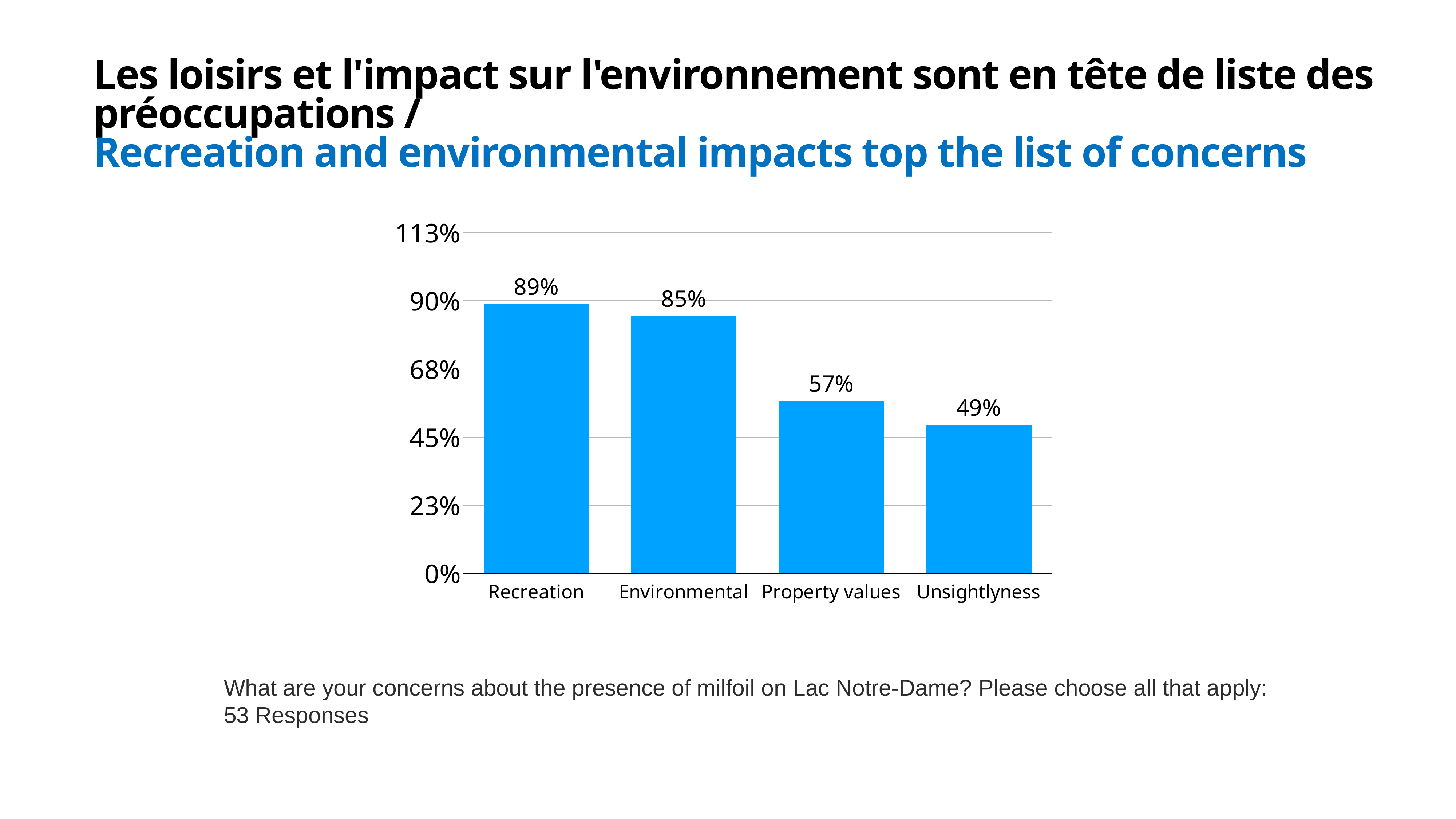
What is the value for Recreation? 89% What is the value for Unsightlyness? 49% Which category has the highest value? Recreation Which category has the lowest value? Unsightlyness How many categories are shown on the x axis? 4 Which is larger, the value for Property values or the value for Unsightlyness? Property values What kind of chart is shown on the slide? Bar chart What is the value for Environmental? 85% What is the difference between the values for Environmental and Property values? 28% What is the difference between the values for Recreation and Unsightlyness? 40% What is the value for Property values? 57% Do the values rise or fall from left to right along the x axis? Fall